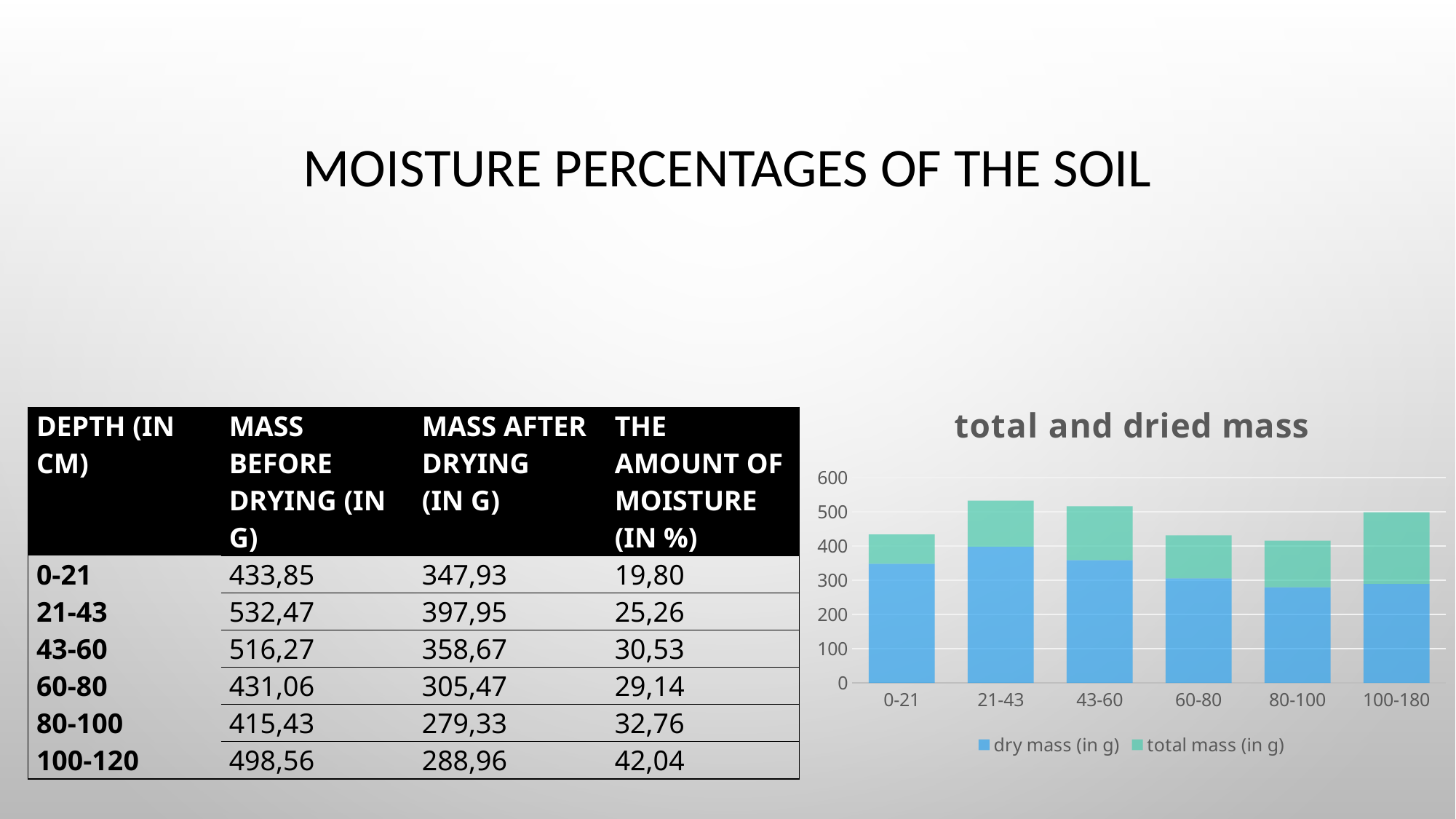
Which series is shown in blue in the chart? dry mass (in g) What is the title of the chart? total and dried mass Is the dry mass for 80-100 greater or less than 300? less How many depth categories are shown on the x axis of the chart? 6 How many series does the chart legend list? 2 Is the total mass for 60-80 greater or less than 500? less Which depth category has the highest dry mass in the chart? 21-43 Which has the larger total mass, 0-21 or 21-43? 21-43 Is the dry mass for 0-21 greater or less than 300? greater Which has the larger dry mass, 21-43 or 43-60? 21-43 What kind of chart is shown on the slide? bar chart